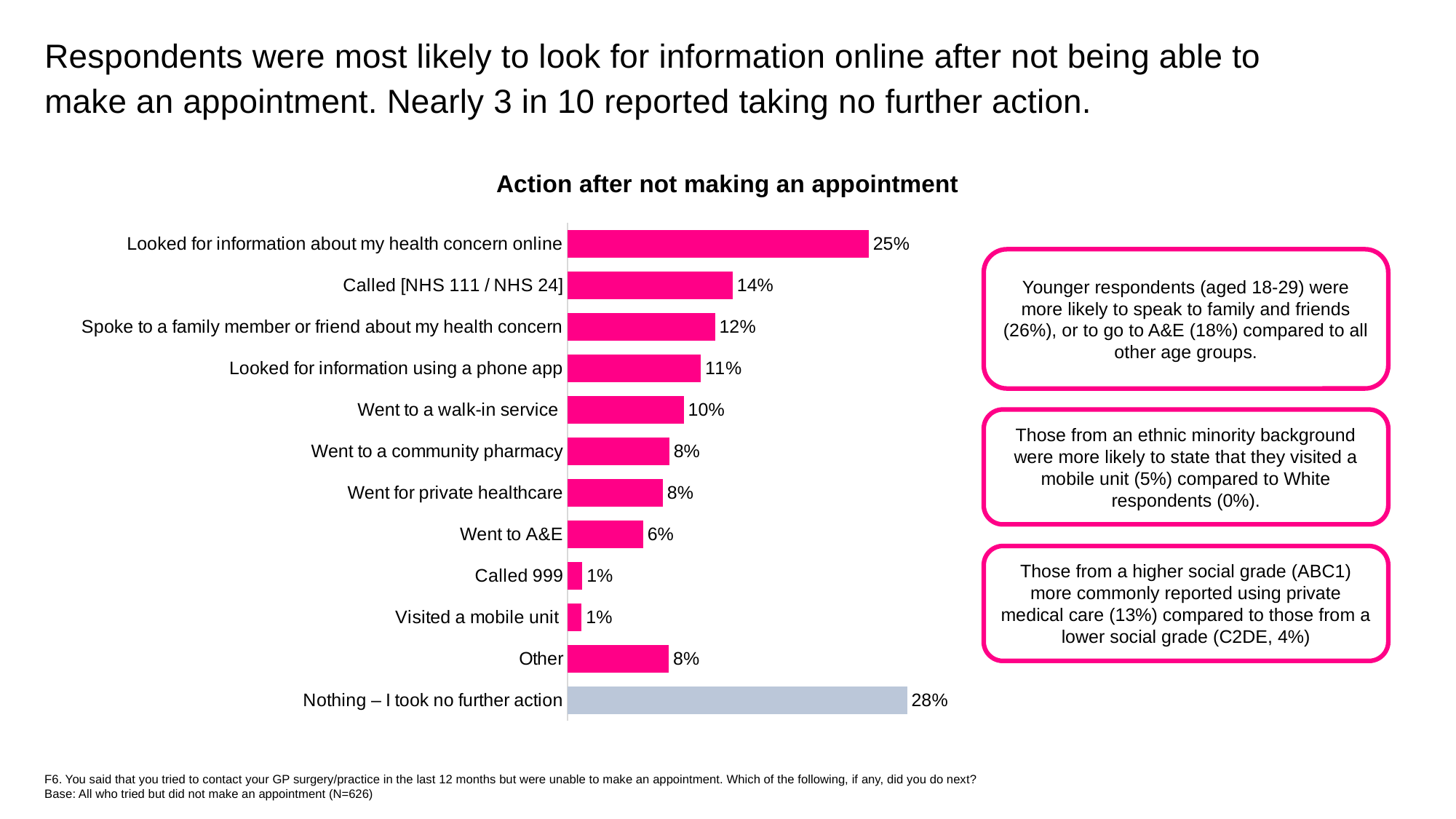
What is the difference between the percentage who looked for information online and the percentage who called [NHS 111 / NHS 24]? 11% What kind of chart is shown on the slide? Bar chart Which bar in the chart is coloured differently from the others? Nothing – I took no further action Which categories have the lowest value in the chart? Called 999 and Visited a mobile unit Which category has the highest value in the chart? Nothing – I took no further action How many categories are shown in the chart? 12 What percentage of respondents called [NHS 111 / NHS 24]? 14% What percentage of respondents looked for information about their health concern online? 25% What percentage of respondents said they took no further action? 28% What is the title of the chart? Action after not making an appointment Which is larger: the value for 'Went to a walk-in service' or the value for 'Went to A&E'? Went to a walk-in service What percentage of respondents went to A&E? 6%